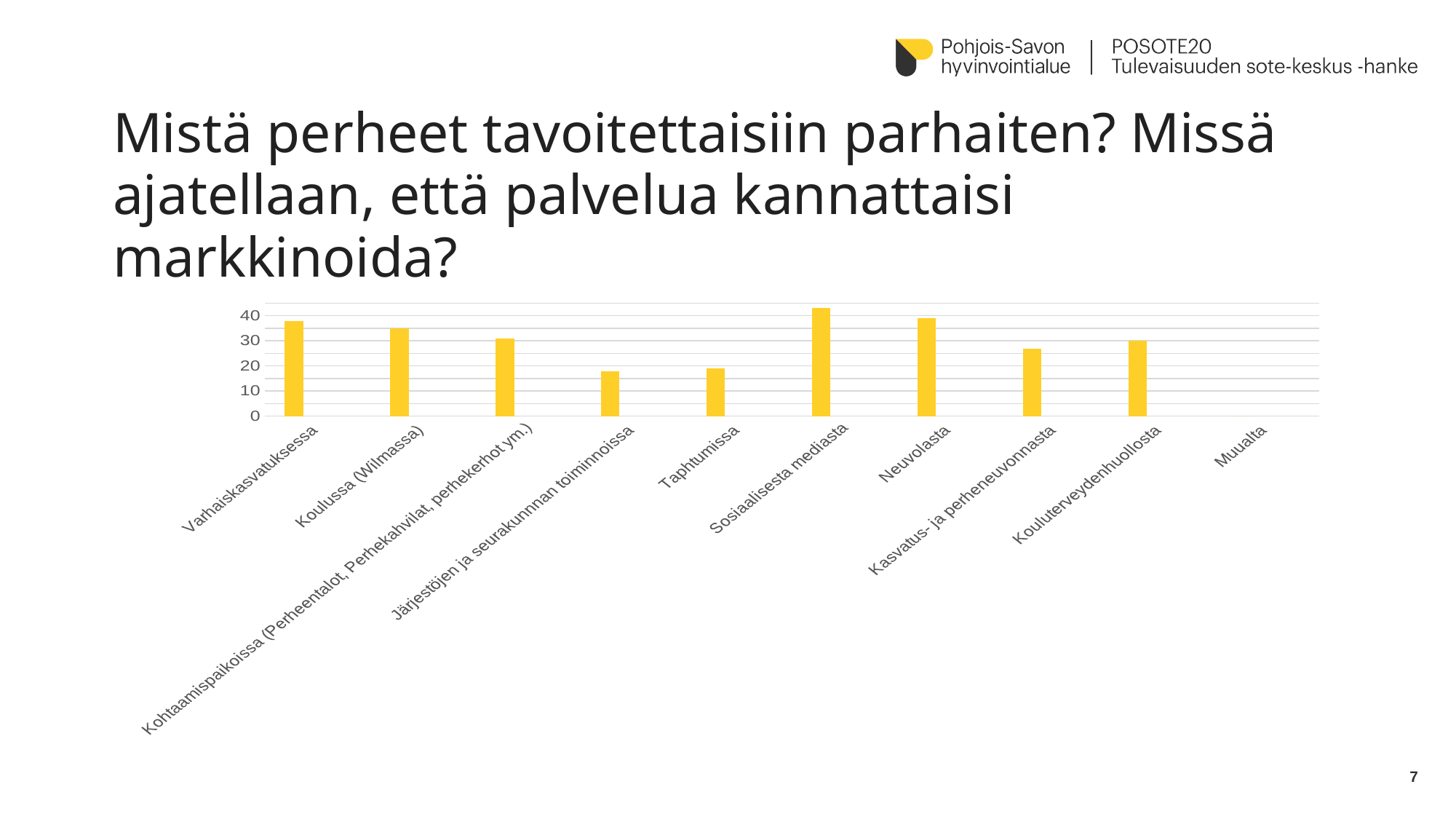
Is the value for Varhaiskasvatuksessa greater or less than 30? greater Which is larger, the value for Kouluterveydenhuollosta or the value for Kasvatus- ja perheneuvonnasta? Kouluterveydenhuollosta Is the value for Kasvatus- ja perheneuvonnasta greater or less than 30? less Is the value for Tapahtumissa greater or less than 10? greater Which category has the highest bar in the chart? Sosiaalisesta mediasta What kind of chart is shown on the slide? bar chart What colour are the bars in the chart? yellow Which is larger, the value for Sosiaalisesta mediasta or the value for Neuvolasta? Sosiaalisesta mediasta How many categories are shown on the x axis of the chart? 10 Which category has the lowest value in the chart? Muualta